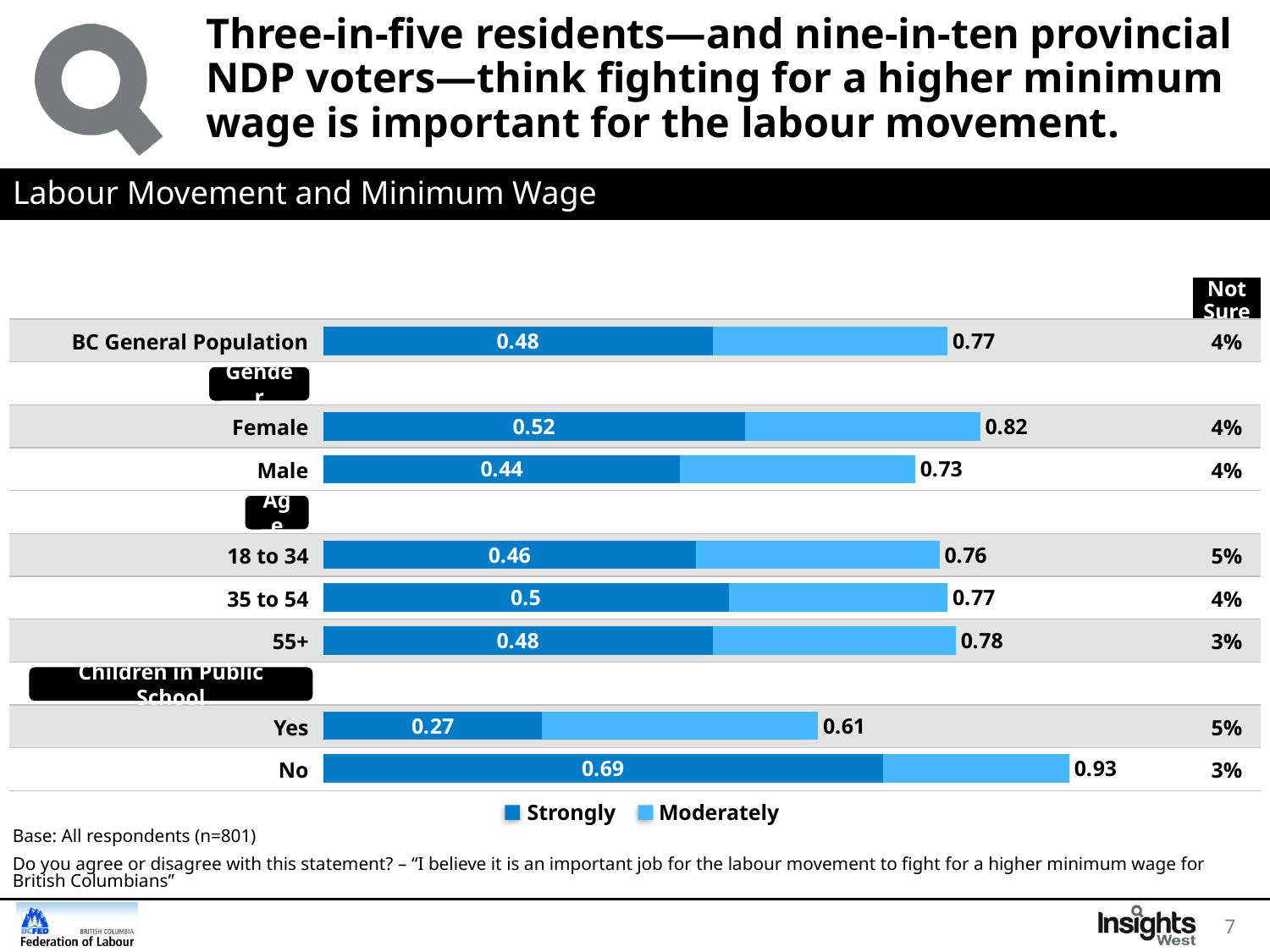
Which category has the lowest Strongly value? Yes What is the Strongly value for BC General Population? 0.48 How many series does the legend list? 2 Which category has the highest Strongly value? No What value is labelled at the end of the bar for Male? 0.73 What kind of chart is shown on the slide? bar chart What value is labelled at the end of the bar for No (Children in Public School)? 0.93 What is the difference between the Strongly values for Female and Male? 0.08 Which has the larger Strongly value, 18 to 34 or 35 to 54? 35 to 54 What is the Not Sure percentage for 18 to 34? 5% What is the Strongly value for Female? 0.52 What are the two series named in the legend? Strongly and Moderately